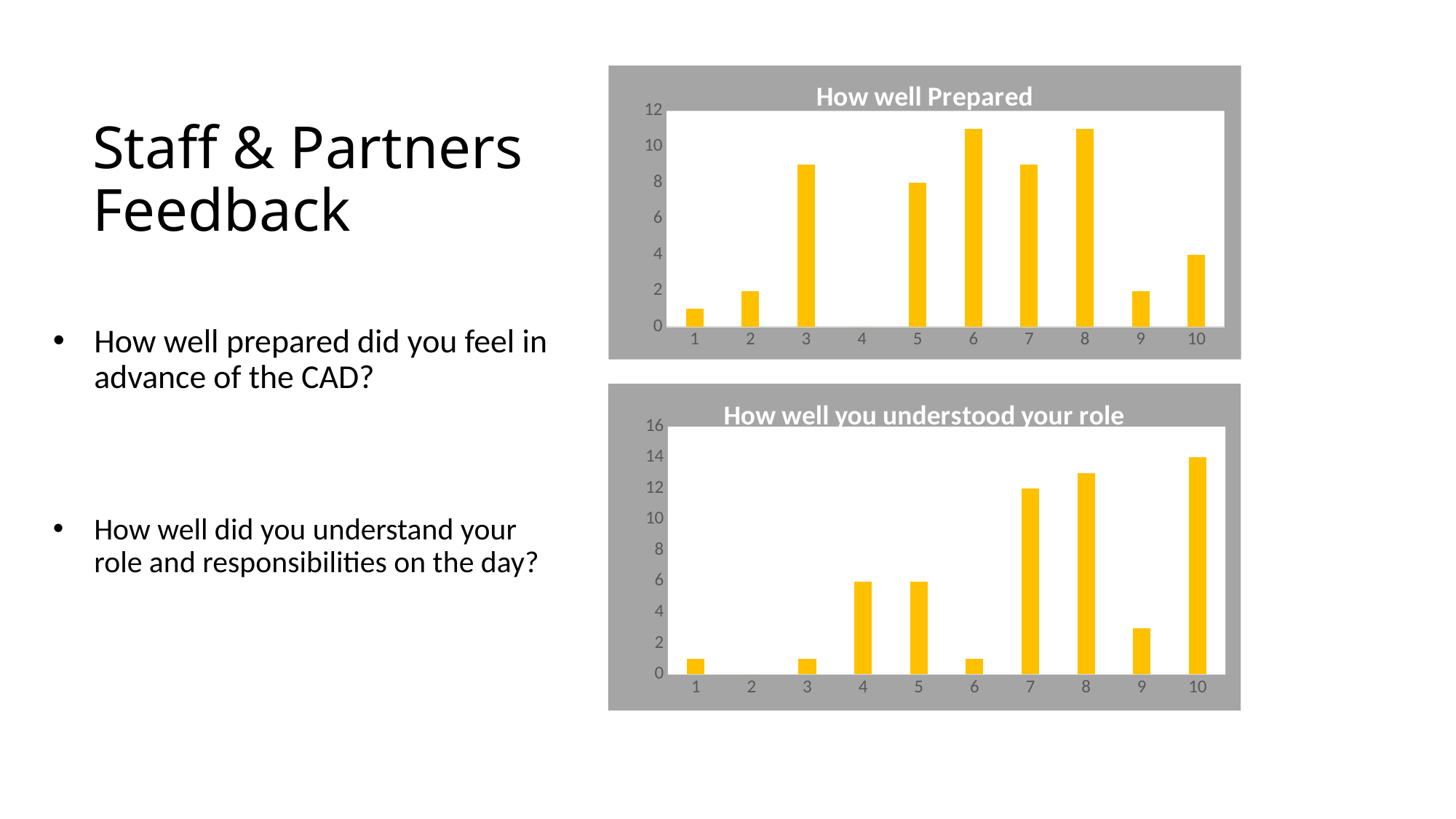
In the 'How well you understood your role' chart, which is larger, the value for category 4 or category 7? category 7 In the 'How well you understood your role' chart, is the value for category 9 greater or less than 4? less In the 'How well you understood your role' chart, what is the value for category 7? 12 What type of chart is the 'How well you understood your role' chart? bar chart In the 'How well you understood your role' chart, which category has the highest value? 10 How many categories are shown on the x axis of the 'How well Prepared' chart? 10 In the 'How well Prepared' chart, what is the value for category 10? 4 In the 'How well Prepared' chart, what is the value for category 5? 8 In the 'How well you understood your role' chart, what is the difference between the values for category 10 and category 7? 2 In the 'How well Prepared' chart, which is larger, the value for category 5 or category 10? category 5 In the 'How well Prepared' chart, is the value for category 3 greater or less than 8? greater In the 'How well you understood your role' chart, what is the value for category 10? 14